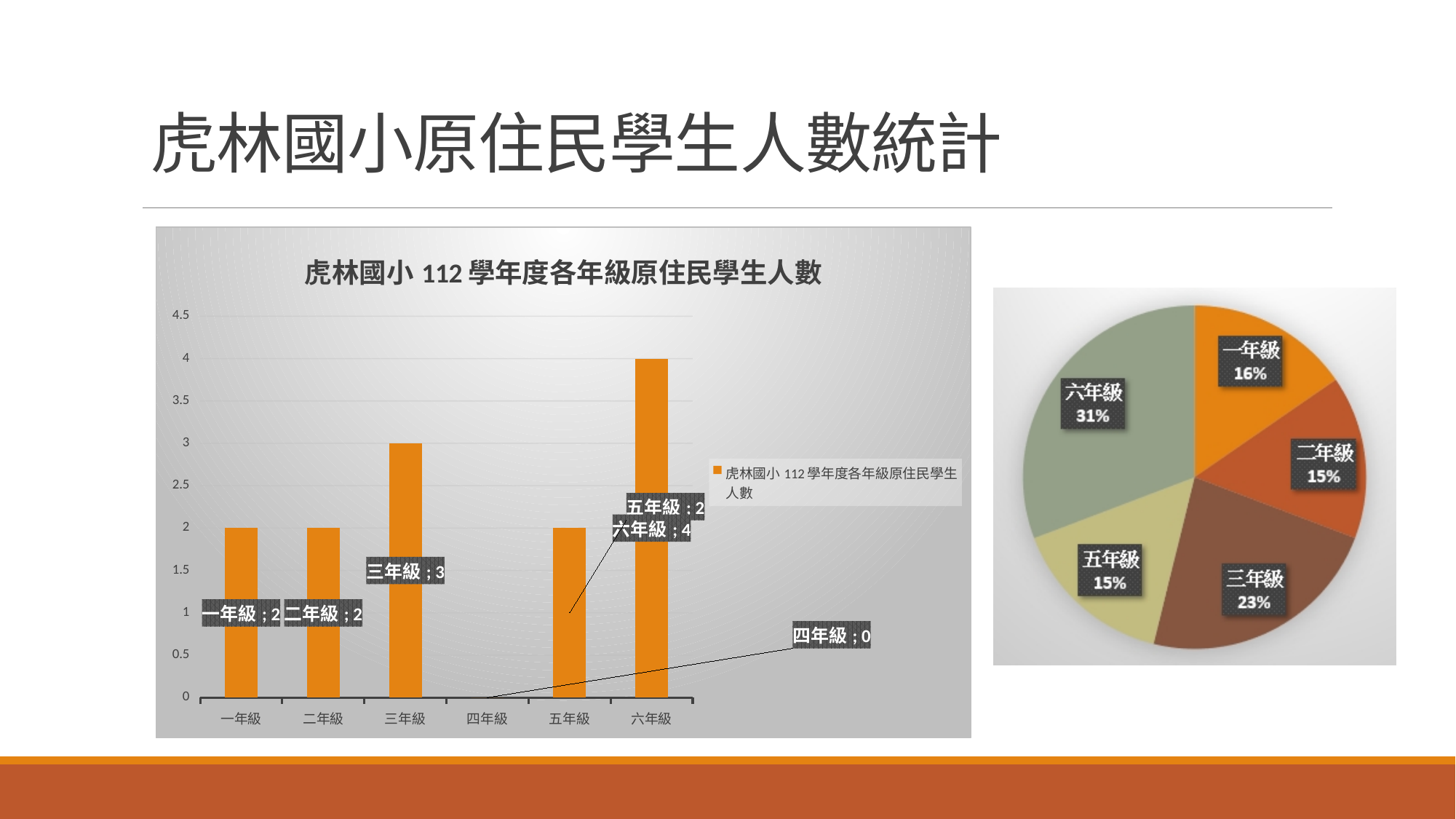
In the pie chart on the right, what share does 三年級 have? 23% In the bar chart on the left, what is the value for 四年級? 0 What type of chart is the chart on the left of the slide? bar chart In the pie chart on the right, what share does 六年級 have? 31% In the bar chart on the left, what is the value for 三年級? 3 How many grade categories are shown on the x axis of the bar chart on the left? 6 In the bar chart on the left, which is larger, the value for 三年級 or the value for 五年級? 三年級 How many slices does the pie chart on the right have? 5 In the bar chart on the left, what is the value for 六年級? 4 In the bar chart on the left, which grade has the lowest value? 四年級 In the bar chart on the left, which grade has the highest value? 六年級 In the bar chart on the left, what is the difference between the values for 六年級 and 三年級? 1